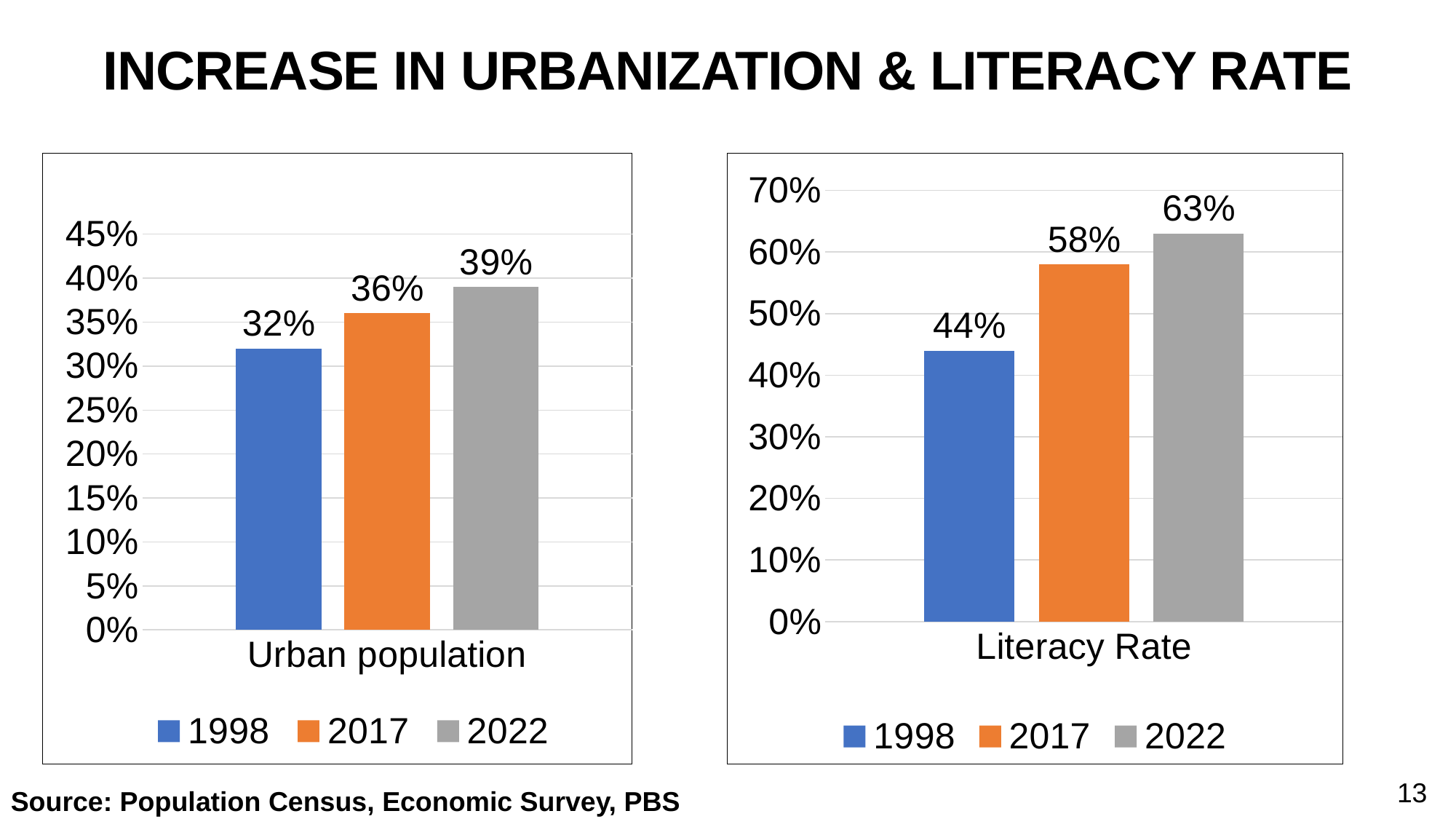
What kind of chart is the right chart (Literacy Rate)? Bar chart In the left chart (Urban population), do the values rise or fall from 1998 to 2022? Rise In the right chart (Literacy Rate), which is larger, the value for 2017 or the value for 2022? 2022 How many series does the legend of the left chart (Urban population) list? 3 In the left chart (Urban population), what is the value for 2022? 39% In the right chart (Literacy Rate), which year has the lowest value? 1998 In the right chart (Literacy Rate), what is the difference between the 2017 and 1998 values? 14% In the left chart (Urban population), which year has the highest value? 2022 In the right chart (Literacy Rate), what is the value for 2017? 58% In the left chart (Urban population), what is the difference between the 2022 and 1998 values? 7% In the left chart (Urban population), what is the value for 1998? 32% In the right chart (Literacy Rate), what is the value for 2022? 63%